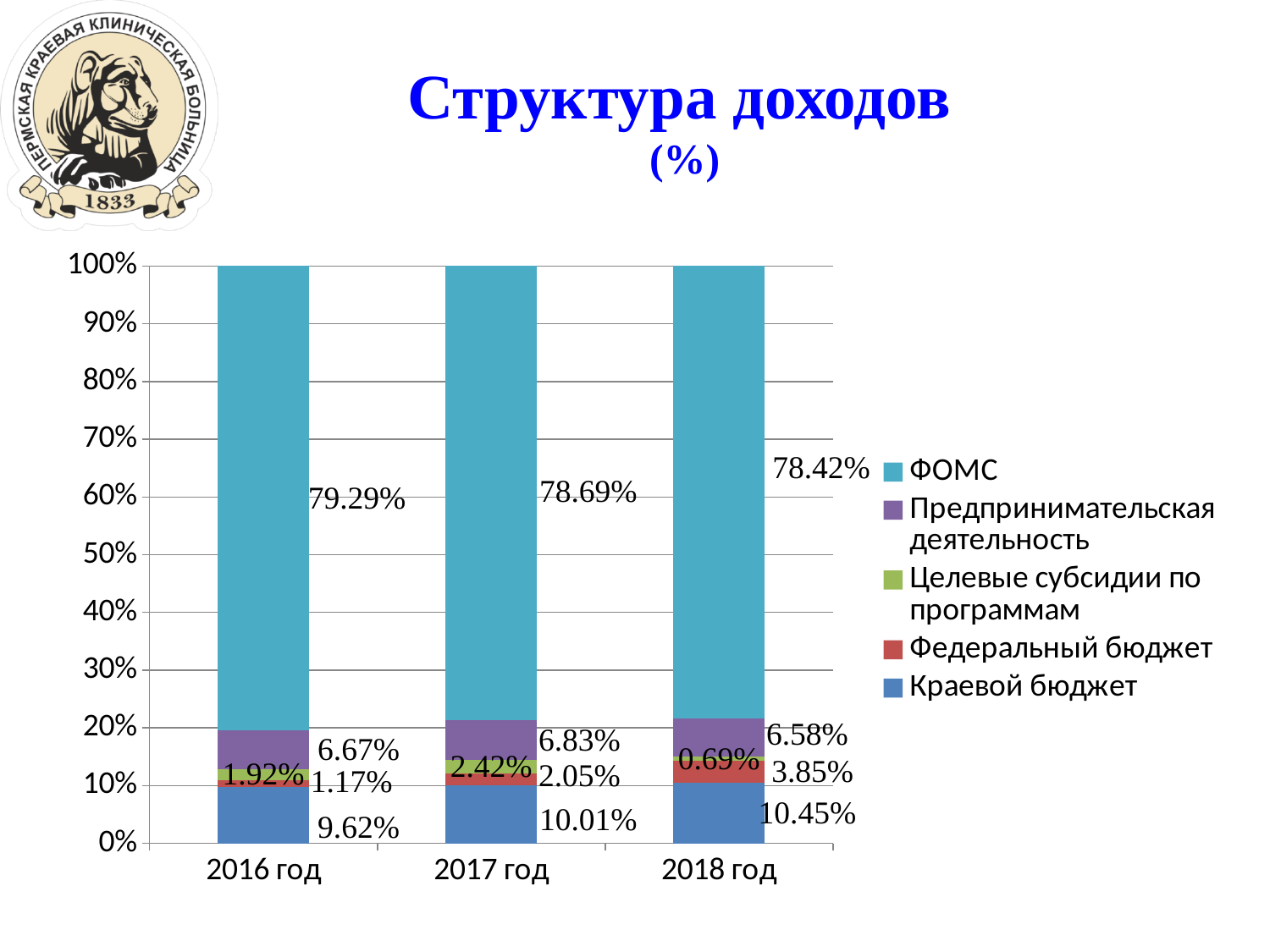
Which is larger: the share of Предпринимательская деятельность in 2017 or in 2018? 2017 год By how many percentage points does the ФОМС share in 2016 exceed that in 2018? 0.87 What is the share of Федеральный бюджет in 2017? 2.05% What is the share of ФОМС in 2016? 79.29% In which year is the share of Целевые субсидии по программам the lowest? 2018 год What is the share of Целевые субсидии по программам in 2018? 0.69% Does the share of ФОМС rise or fall from 2016 to 2018? Fall How many years (categories) are shown on the x axis? 3 How many series does the legend list? 5 What is the share of Краевой бюджет in 2018? 10.45% In which year is the share of ФОМС the highest? 2016 год What type of chart is shown on the slide? Stacked bar chart